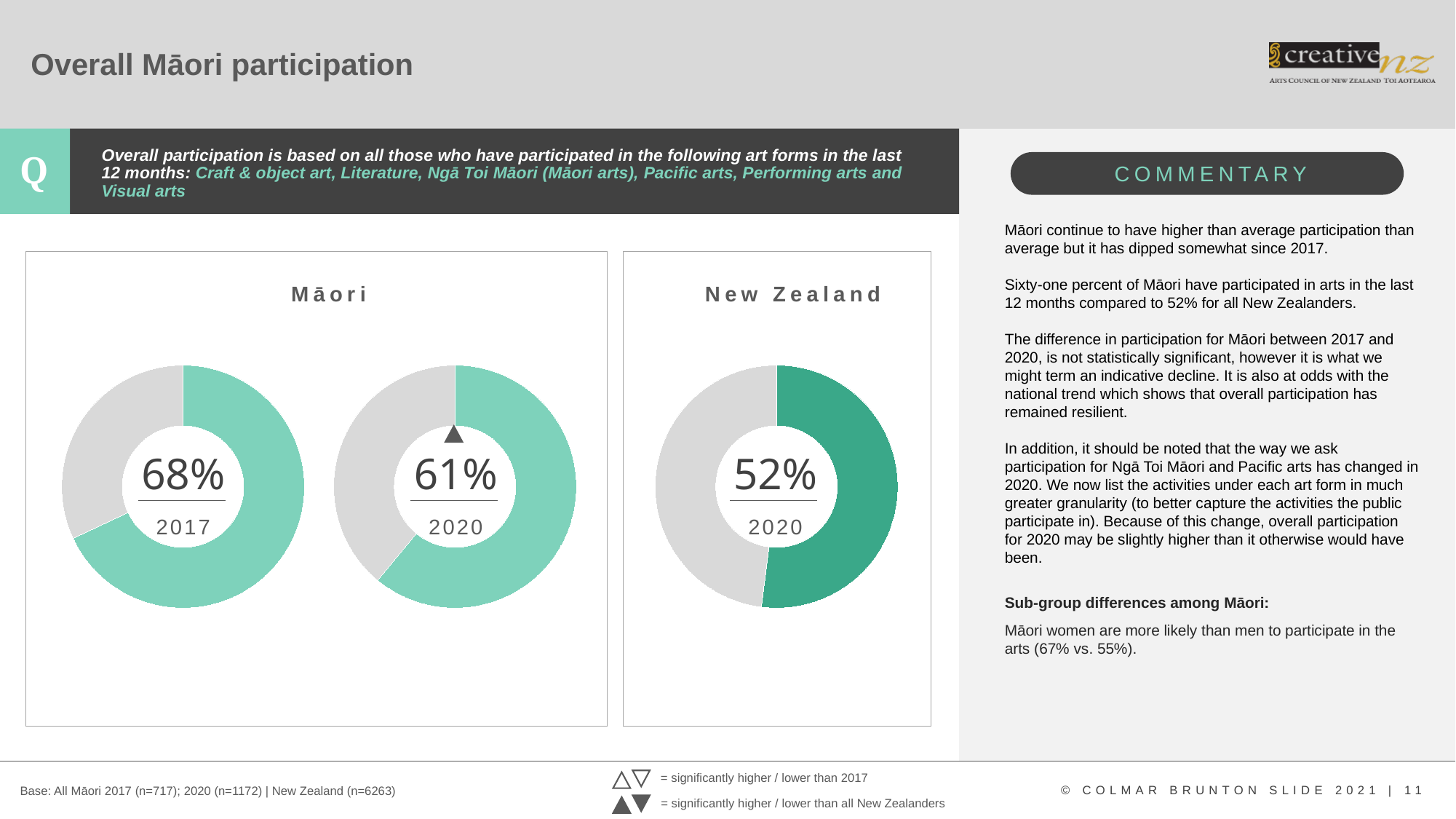
How many donut charts are shown on the slide in total? 3 Which is larger: Māori participation in 2020 or New Zealand participation in 2020? Māori participation in 2020 In the Māori chart, did participation rise or fall from 2017 to 2020? Fall In the Māori chart, by how many percentage points did participation change from 2017 to 2020? 7 percentage points Across all three donut charts, which has the lowest participation value? New Zealand 2020 (52%) What is the difference between Māori participation in 2020 and New Zealand participation in 2020? 9 percentage points Across all three donut charts, which has the highest participation value? Māori 2017 (68%) What is the title of the chart panel on the right side of the chart area? New Zealand What type of chart is used to show the participation values on this slide? Donut (pie) chart In the Māori chart, what is the overall participation value for 2017? 68% In the Māori chart, what is the overall participation value for 2020? 61% In the New Zealand chart, what is the overall participation value for 2020? 52%